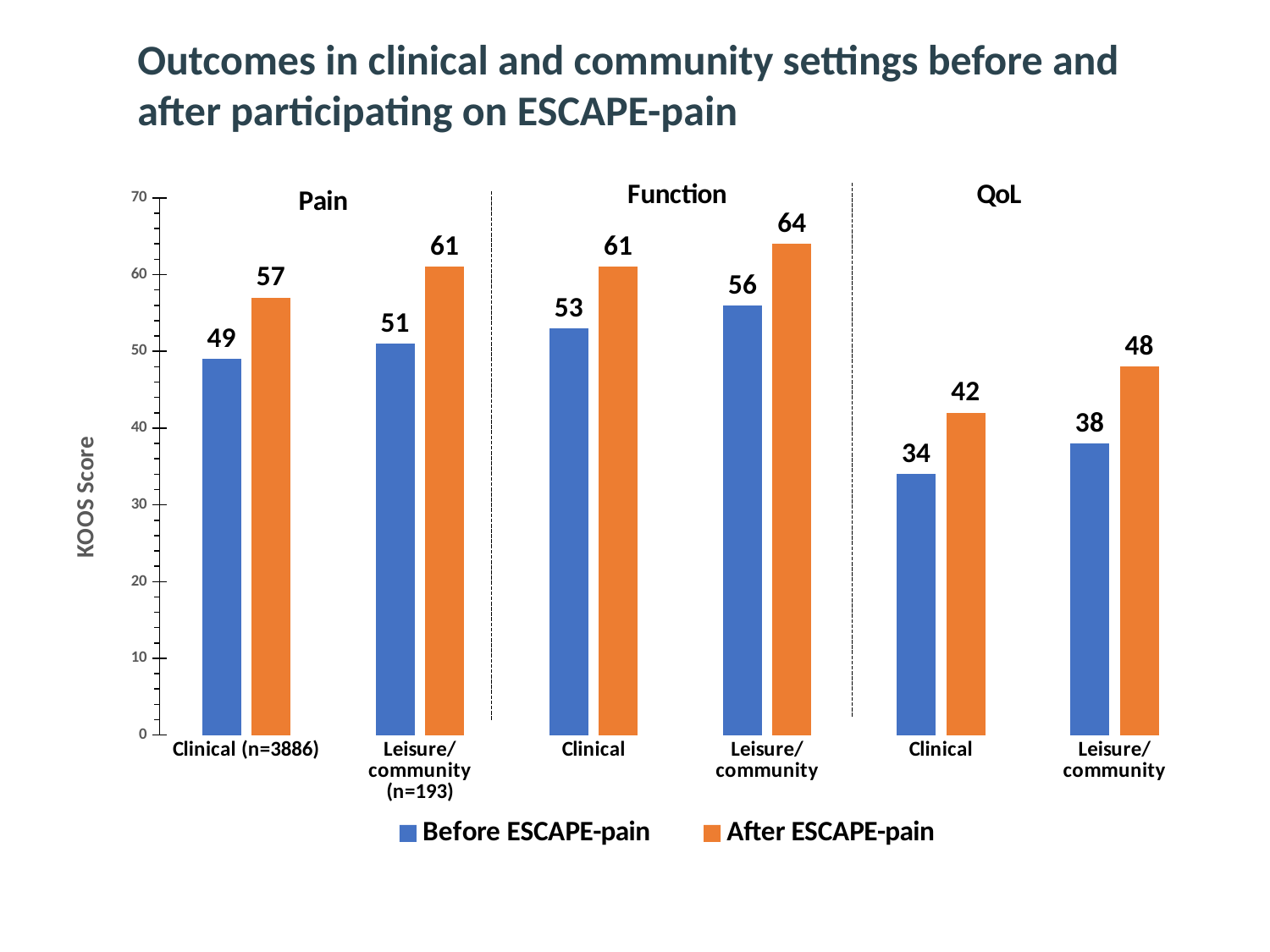
Which bar has the highest value on the chart? After ESCAPE-pain, Function, Leisure/community (64) Which is larger: the Before ESCAPE-pain Function score for Clinical or for Leisure/community? Leisure/community What is the Before ESCAPE-pain Pain score for the Clinical (n=3886) group? 49 Which bar has the lowest value on the chart? Before ESCAPE-pain, QoL, Clinical (34) What is the label on the vertical axis? KOOS Score Is the After ESCAPE-pain QoL score for the Clinical group greater or less than 40? greater What is the difference between the After and Before ESCAPE-pain QoL scores for the Leisure/community group? 10 What is the Before ESCAPE-pain QoL score for the Clinical group? 34 What is the difference between the After ESCAPE-pain Pain scores for the Leisure/community and Clinical groups? 4 What kind of chart is shown on the slide? Bar chart How many series does the legend list? 2 What is the After ESCAPE-pain Function score for the Leisure/community group? 64